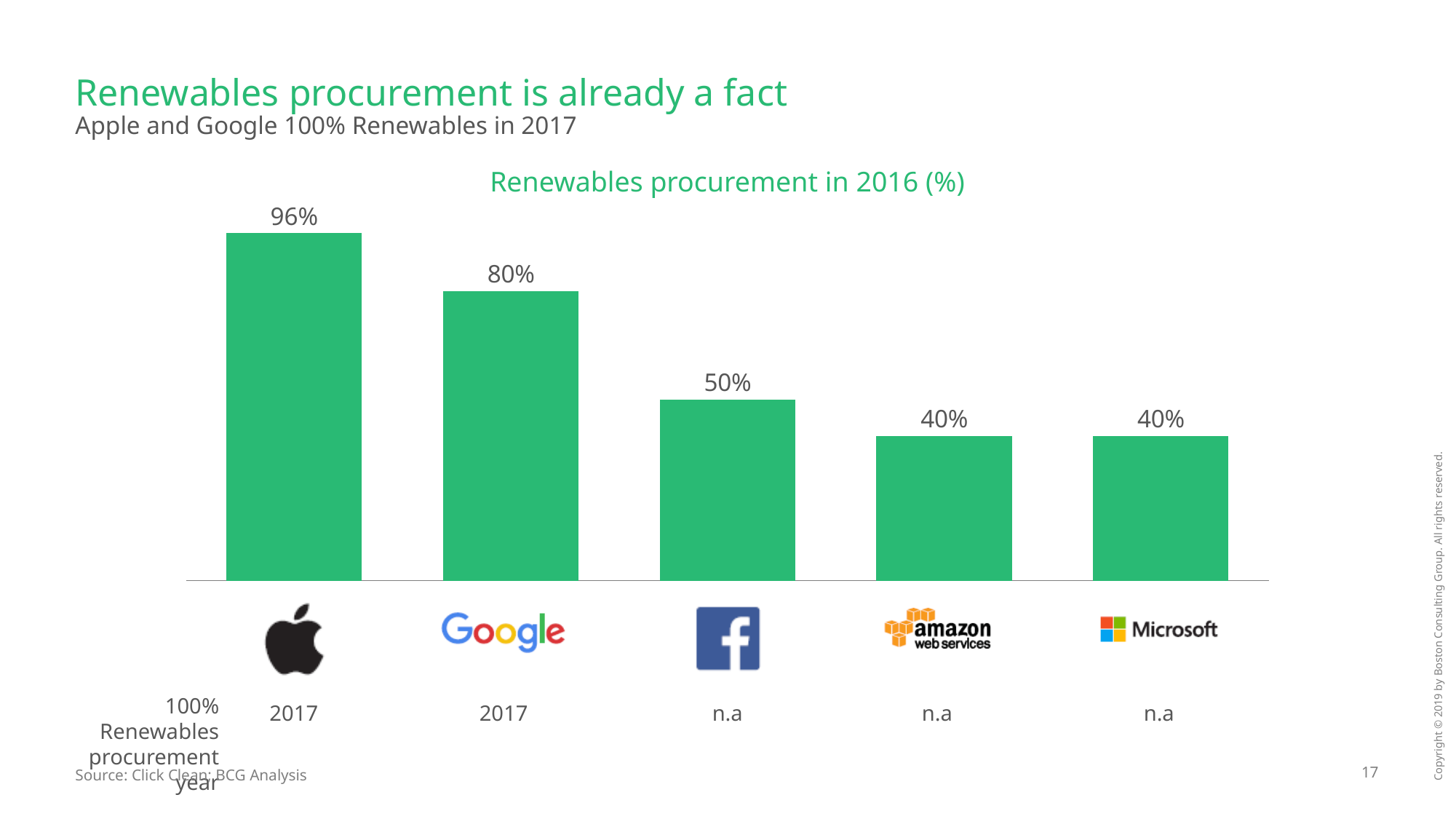
Do the values rise or fall from left to right across the chart? Fall What is the renewables procurement value for Apple? 96% What is the renewables procurement value for Amazon Web Services? 40% Which company has the highest renewables procurement in 2016? Apple What is the difference between Apple's and Google's renewables procurement values? 16% How many companies are shown in the chart? 5 What is the renewables procurement value for Facebook? 50% What is the difference between Google's and Facebook's renewables procurement values? 30% What is the title of the chart? Renewables procurement in 2016 (%) Which is larger, the value for Google or the value for Microsoft? Google What is the renewables procurement value for Google? 80% What kind of chart is shown on the slide? Bar chart